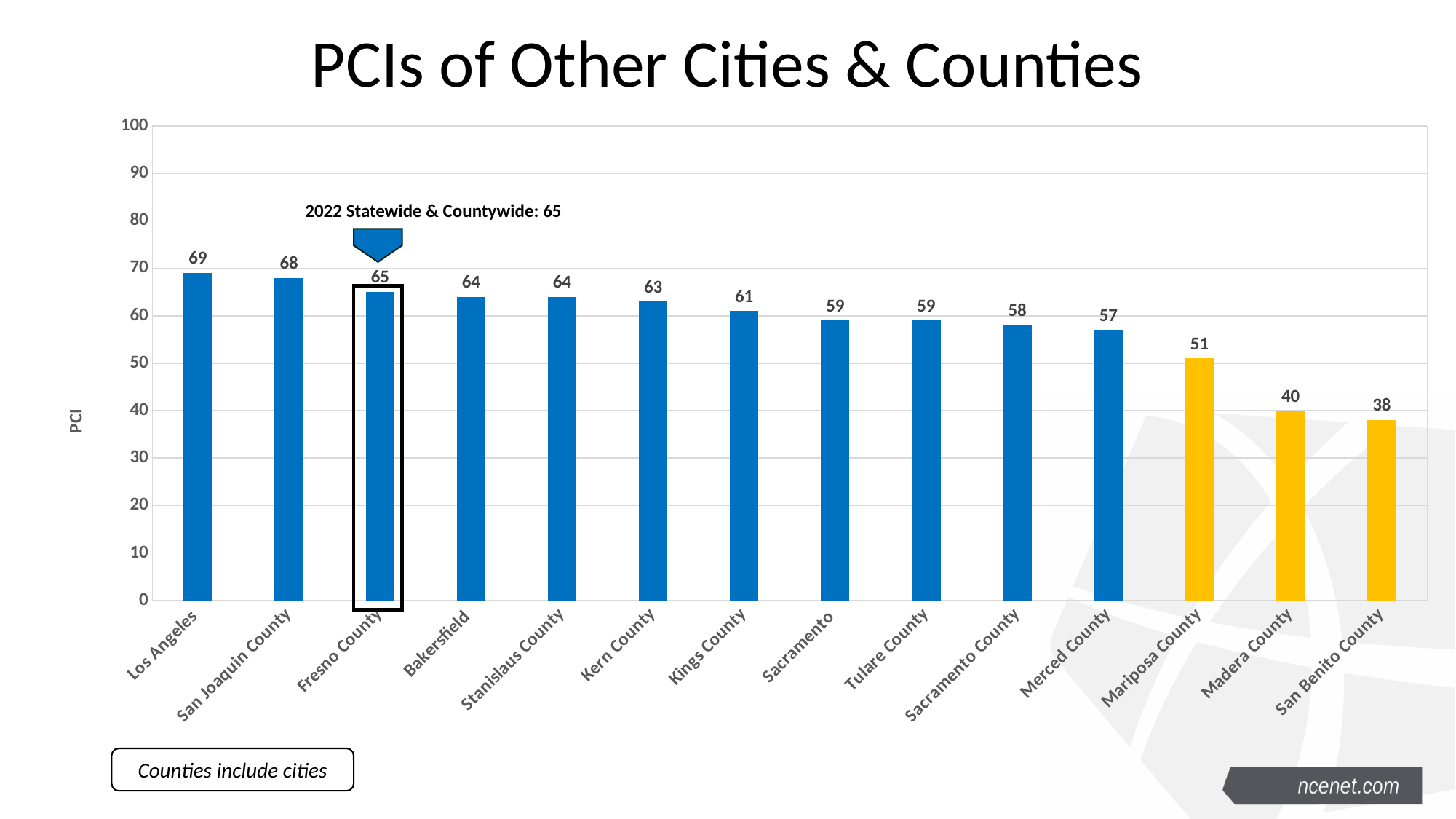
Which city or county has the highest PCI? Los Angeles Which city or county has the lowest PCI? San Benito County What is the PCI value for Kern County? 63 What is the difference between the PCI of Los Angeles and the PCI of San Benito County? 31 What is the PCI value for Fresno County? 65 What is the PCI value for Mariposa County? 51 What is the 2022 Statewide & Countywide PCI value noted on the chart? 65 Which has a higher PCI, Bakersfield or Kings County? Bakersfield What is the difference between the PCI of Merced County and the PCI of Madera County? 17 Is the PCI value for Madera County greater or less than 50? less What kind of chart is shown on the slide? Bar chart How many cities and counties are shown on the chart? 14